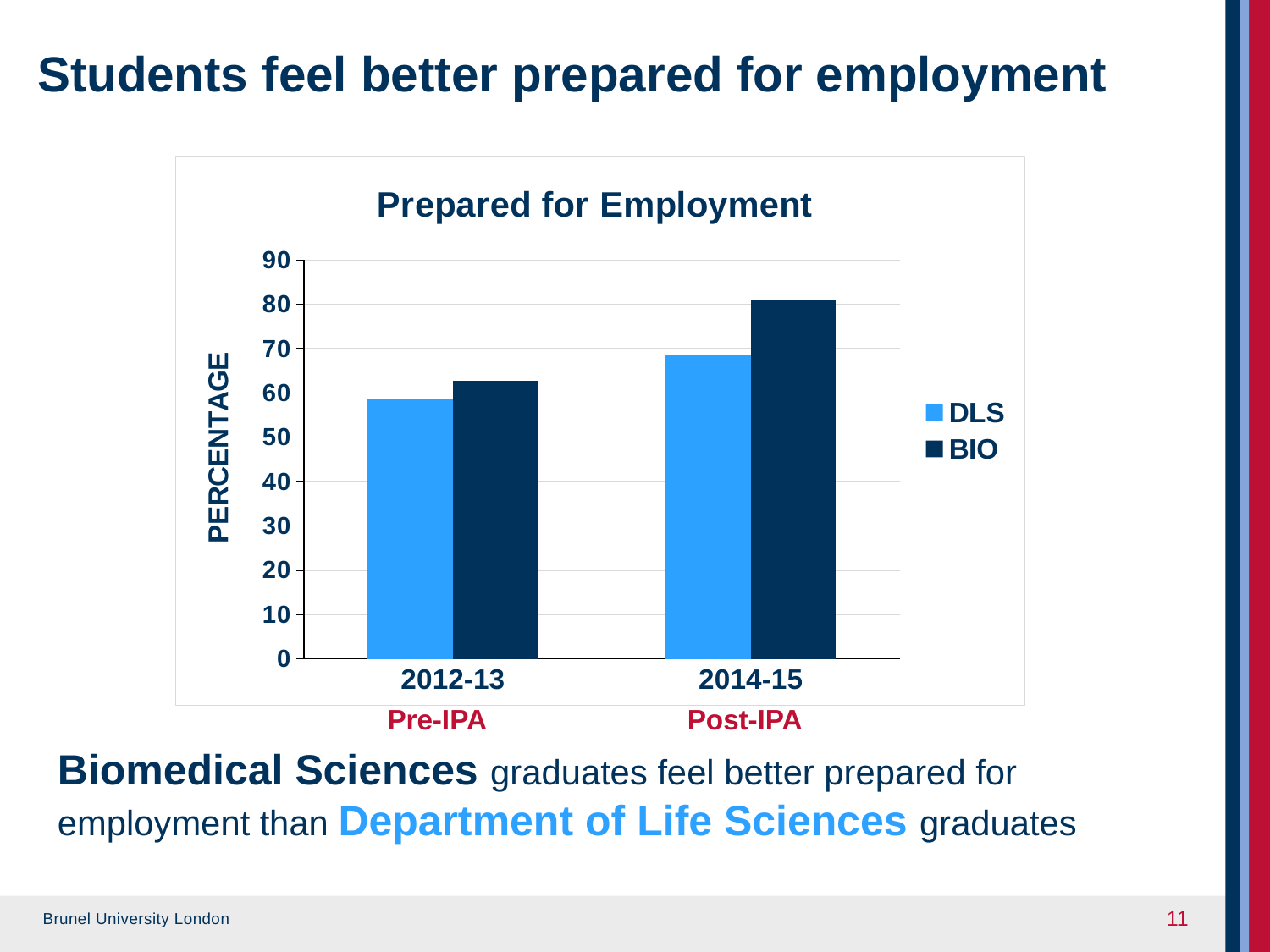
Is the value for DLS in 2014-15 greater or less than 60? greater Is the value for BIO in 2012-13 greater or less than 70? less Which series and year has the lowest bar in the chart? DLS in 2012-13 In 2014-15, which series has the larger value, DLS or BIO? BIO What type of chart is shown on the slide? Bar chart Which series and year has the highest bar in the chart? BIO in 2014-15 Is the value for BIO in 2014-15 greater or less than 70? greater In 2012-13, which series has the larger value, DLS or BIO? BIO Does the DLS value rise or fall from 2012-13 to 2014-15? Rise How many series does the chart legend list? 2 How many categories are shown on the x axis of the chart? 2 What is the title of the chart? Prepared for Employment